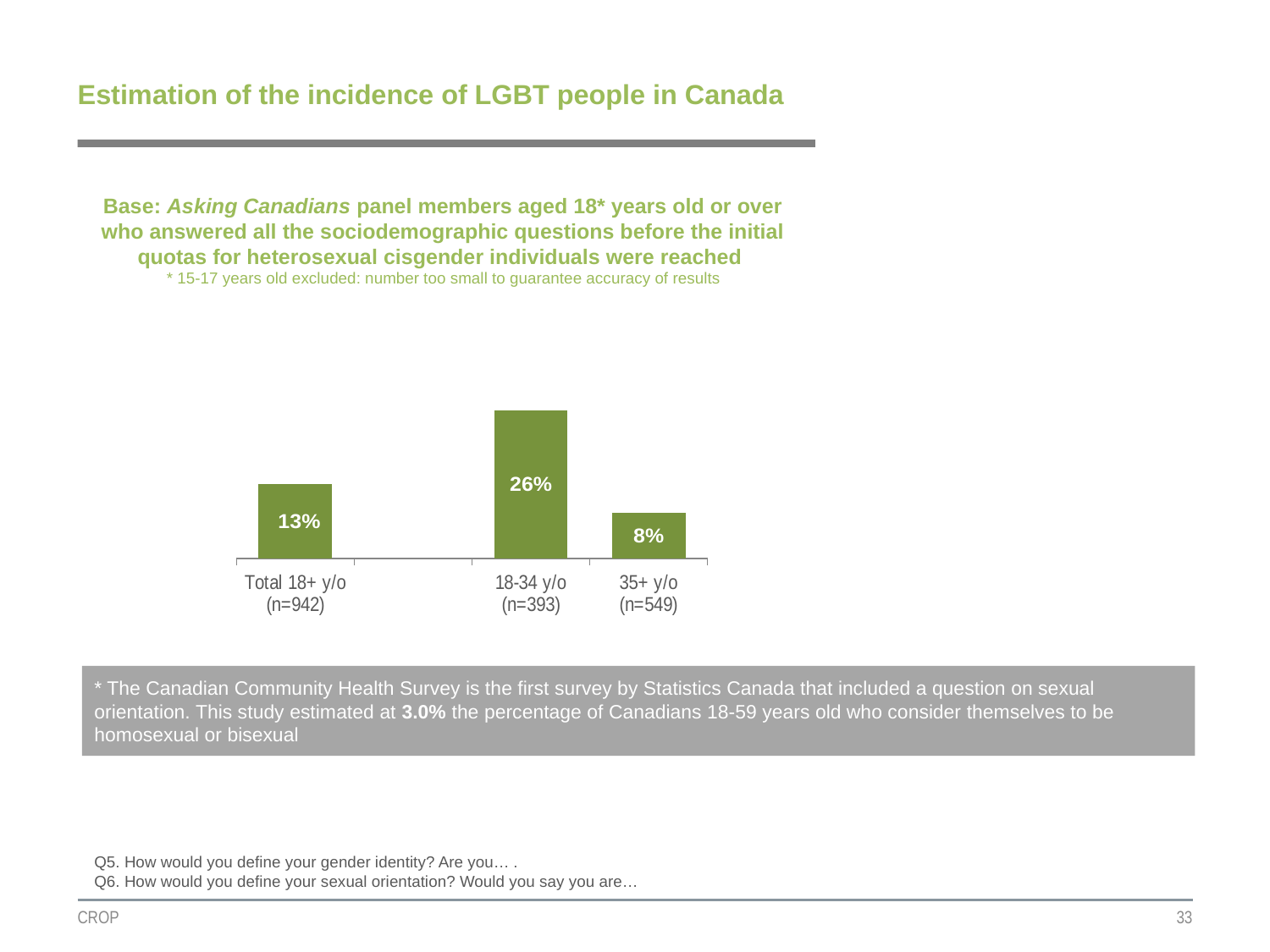
Which category has the lowest value? 35+ y/o (n=549) What is the value for 35+ y/o (n=549)? 8% Which is larger, the value for Total 18+ y/o or the value for 35+ y/o? Total 18+ y/o How many categories are shown in the chart? 3 Which category has the highest value? 18-34 y/o (n=393) What is the value for Total 18+ y/o (n=942)? 13% What is the sample size (n) shown for the 18-34 y/o category? n=393 What is the value for 18-34 y/o (n=393)? 26% What is the difference between the values for 18-34 y/o and 35+ y/o? 18% What is the difference between the values for 18-34 y/o and Total 18+ y/o? 13% What colour are the bars in the chart? Green What kind of chart is shown on the slide? Bar chart